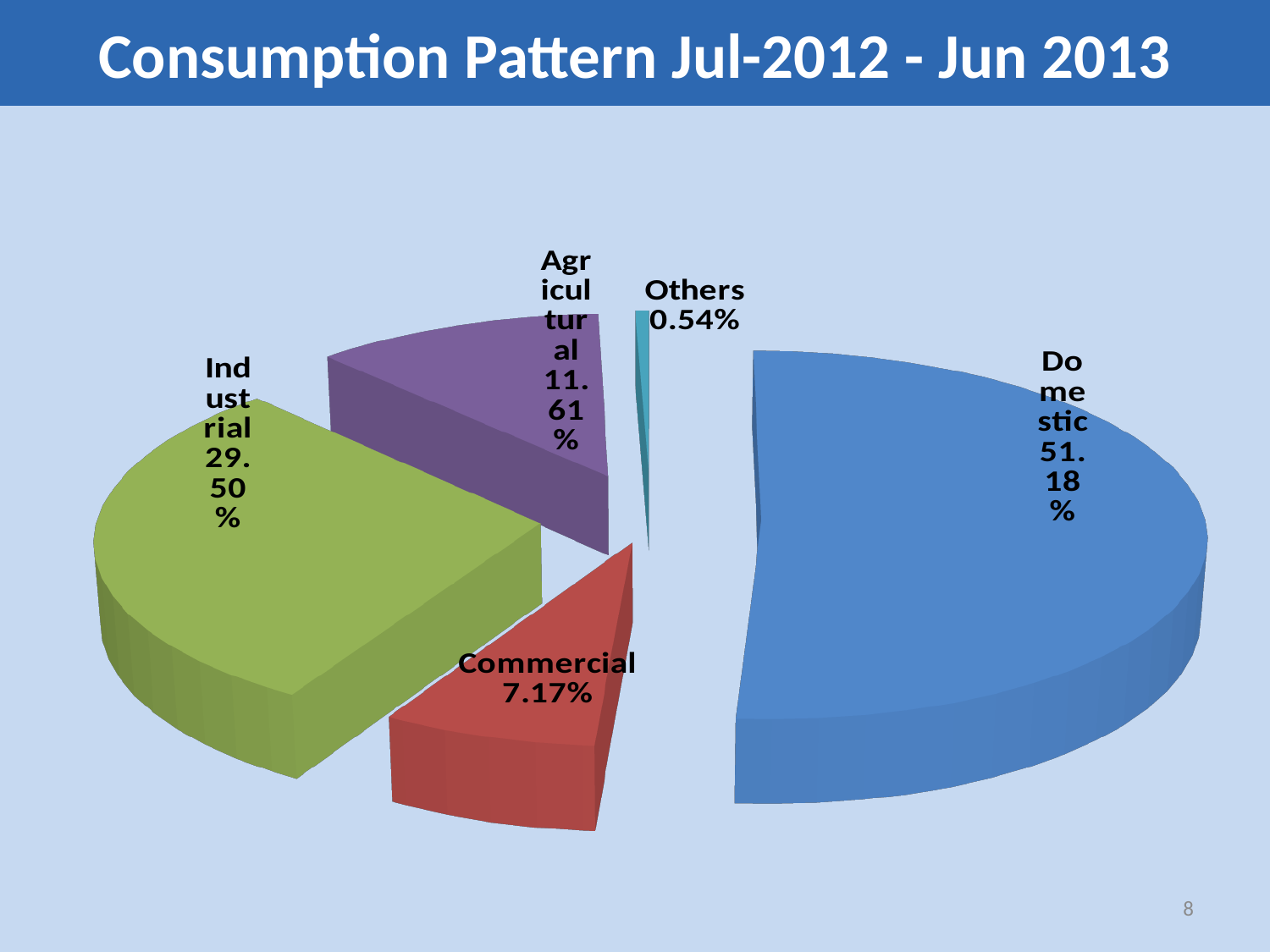
What share of consumption is Domestic? 51.18% What share of consumption is Industrial? 29.50% Which category has the largest share of consumption? Domestic Which is larger, the Agricultural share or the Commercial share? Agricultural Which category has the smallest share of consumption? Others What is the difference between the Domestic and Industrial shares? 21.68% What is the title of the chart? Consumption Pattern Jul-2012 - Jun 2013 What share of consumption is Commercial? 7.17% How many categories are shown in the pie chart? 5 What share of consumption is Agricultural? 11.61% What kind of chart is shown on the slide? Pie chart What share of consumption is Others? 0.54%